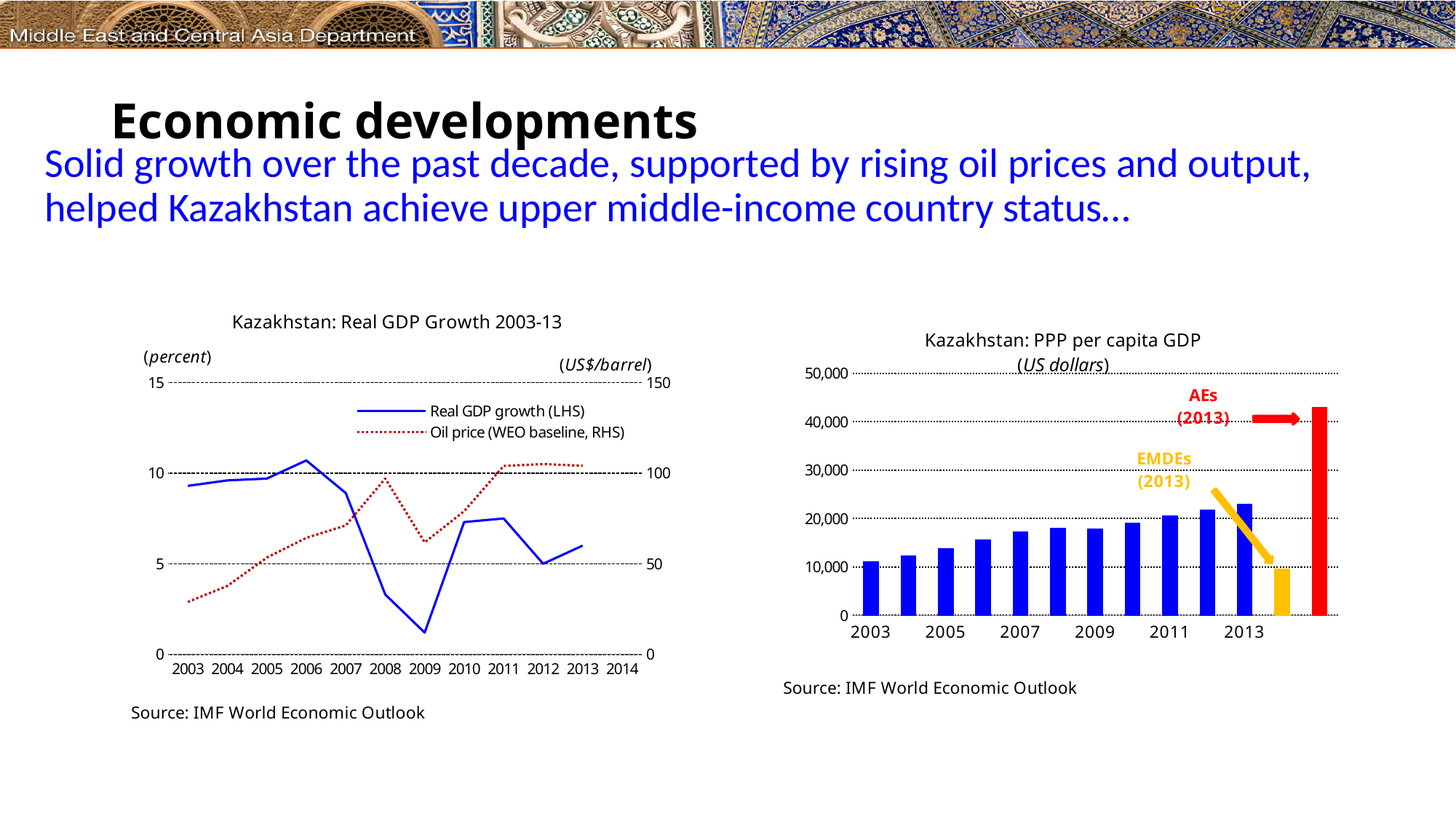
In the 'Kazakhstan: PPP per capita GDP' chart, what colour is the AEs (2013) bar? red What kind of chart is the 'Kazakhstan: Real GDP Growth 2003-13' chart? line chart In the 'Kazakhstan: Real GDP Growth 2003-13' chart, is real GDP growth in 2009 greater or less than 5 percent? less In the 'Kazakhstan: PPP per capita GDP' chart, is the value for AEs (2013) greater or less than 40,000? greater In the 'Kazakhstan: PPP per capita GDP' chart, which bar is the highest? AEs (2013) In the 'Kazakhstan: Real GDP Growth 2003-13' chart, which year has the highest real GDP growth? 2006 In the 'Kazakhstan: PPP per capita GDP' chart, which is larger: Kazakhstan's 2013 bar or the EMDEs (2013) bar? Kazakhstan's 2013 bar In the 'Kazakhstan: Real GDP Growth 2003-13' chart, does the oil price rise or fall from 2003 to 2008? rise In the 'Kazakhstan: Real GDP Growth 2003-13' chart, how many series does the legend list? 2 In the 'Kazakhstan: Real GDP Growth 2003-13' chart, is the oil price in 2003 greater or less than 50 US$/barrel? less In the 'Kazakhstan: Real GDP Growth 2003-13' chart, which year has the lowest real GDP growth? 2009 What kind of chart is the 'Kazakhstan: PPP per capita GDP' chart? bar chart